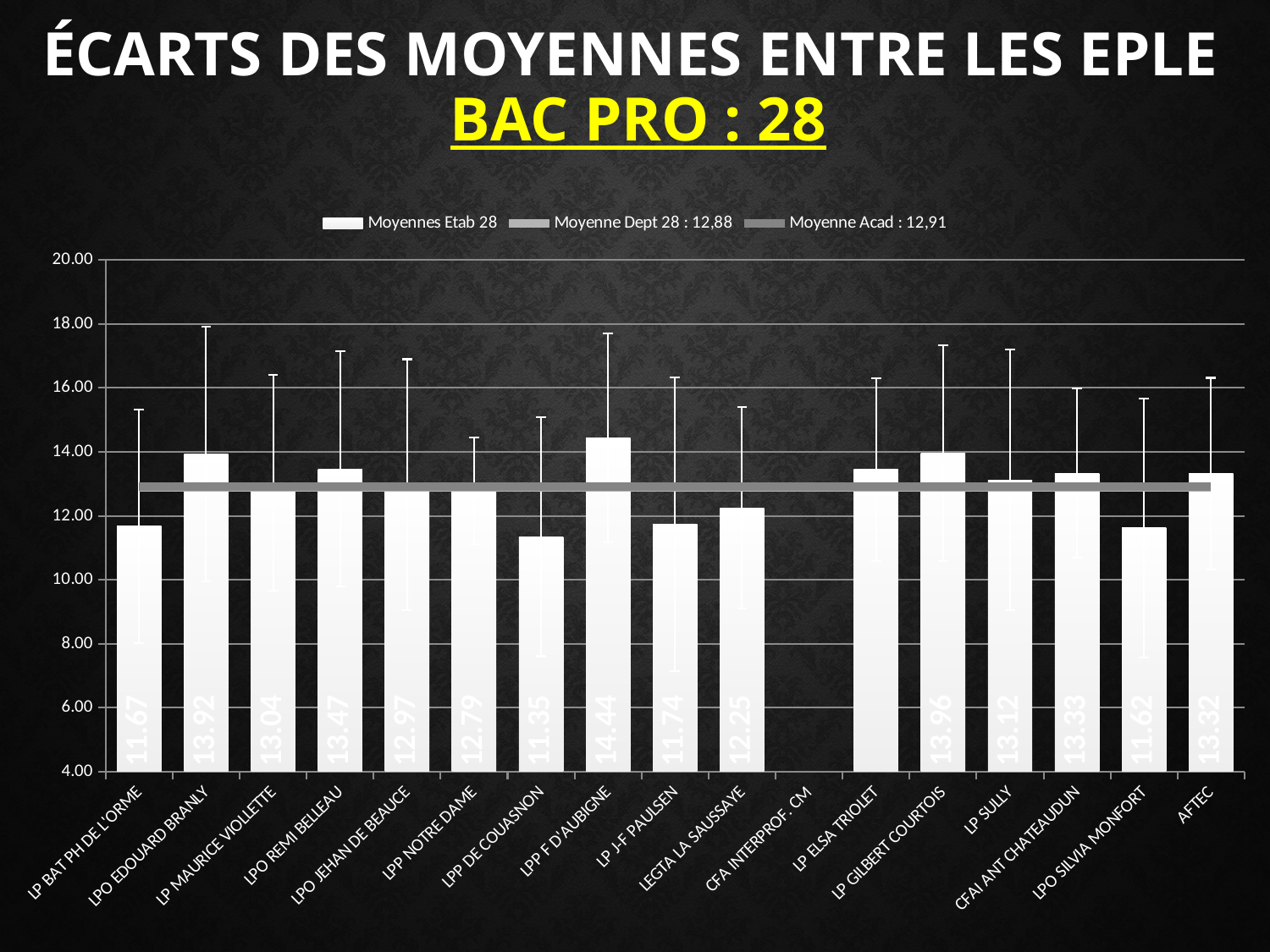
Which establishment has the lowest average? LPP DE COUASNON Which is larger, the value for LPO REMI BELLEAU or for LEGTA LA SAUSSAYE? LPO REMI BELLEAU Which establishment has the highest average? LPP F D'AUBIGNE How many series does the legend list? 3 Is the value for LP ELSA TRIOLET greater or less than 12.00? greater What is the value for LPO SILVIA MONFORT? 11.62 What value does the legend give for Moyenne Dept 28? 12,88 What kind of chart is shown on the slide? bar chart How many establishments are listed on the x axis? 17 What is the value for LPP F D'AUBIGNE? 14.44 What is the difference between the values for LPP F D'AUBIGNE and LPP DE COUASNON? 3.09 What is the value for LEGTA LA SAUSSAYE? 12.25